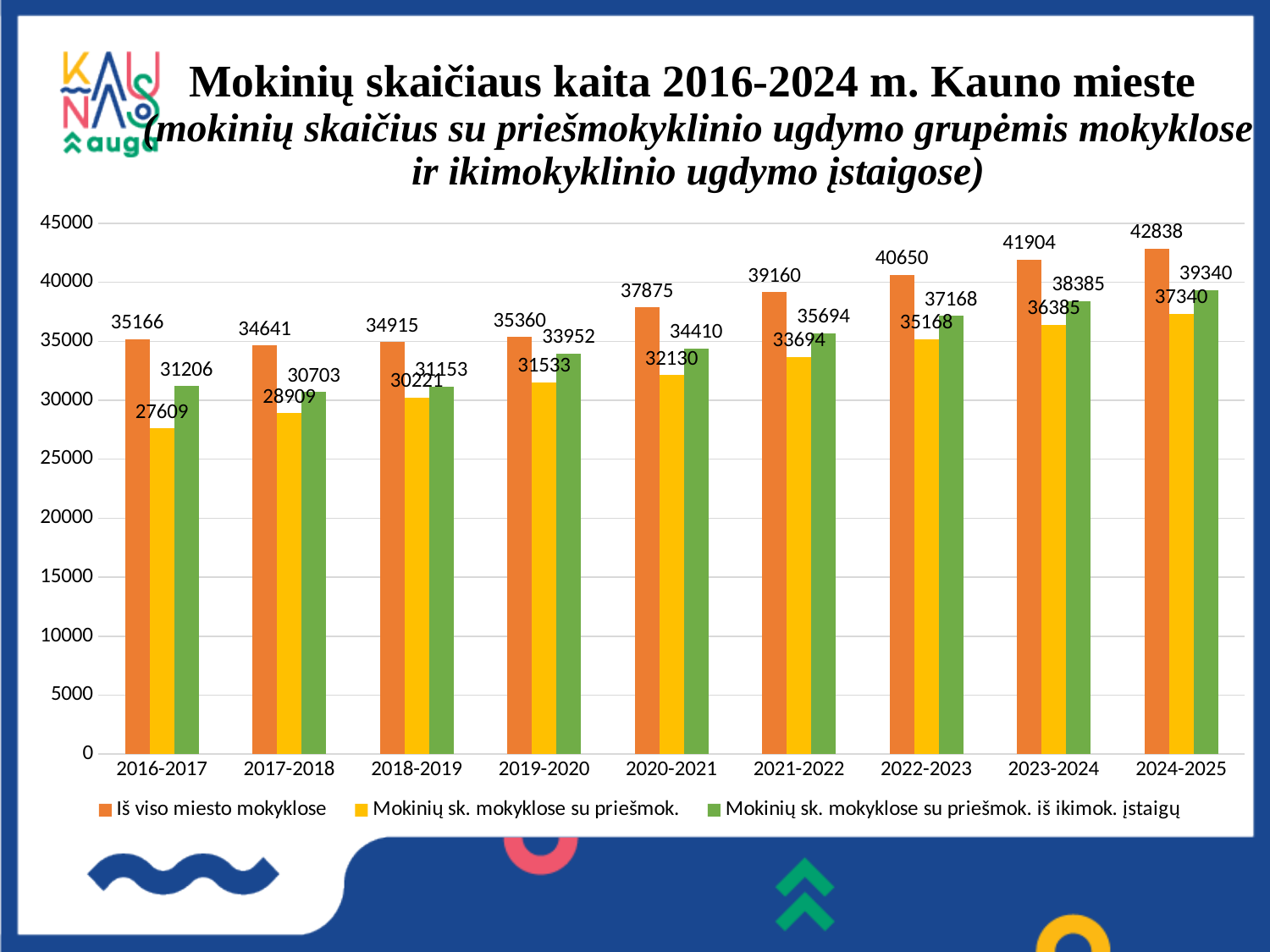
What is the value for 'Mokinių sk. mokyklose su priešmok.' in 2016-2017? 27609 What is the value for 'Iš viso miesto mokyklose' in 2024-2025? 42838 What is the difference between 'Iš viso miesto mokyklose' and 'Mokinių sk. mokyklose su priešmok.' in 2024-2025? 5498 What is the value for 'Mokinių sk. mokyklose su priešmok. iš ikimok. įstaigų' in 2020-2021? 34410 Which is larger in 2018-2019: 'Mokinių sk. mokyklose su priešmok.' or 'Mokinių sk. mokyklose su priešmok. iš ikimok. įstaigų'? Mokinių sk. mokyklose su priešmok. iš ikimok. įstaigų What kind of chart is shown on the slide? bar chart Does the value for 'Mokinių sk. mokyklose su priešmok.' rise or fall from 2016-2017 to 2024-2025? rise In which school year is the value for 'Mokinių sk. mokyklose su priešmok.' the highest? 2024-2025 Is the value for 'Iš viso miesto mokyklose' in 2022-2023 greater or less than 40000? greater How many school years are shown on the x axis? 9 In which school year is the value for 'Iš viso miesto mokyklose' the lowest? 2017-2018 How many series does the legend list? 3